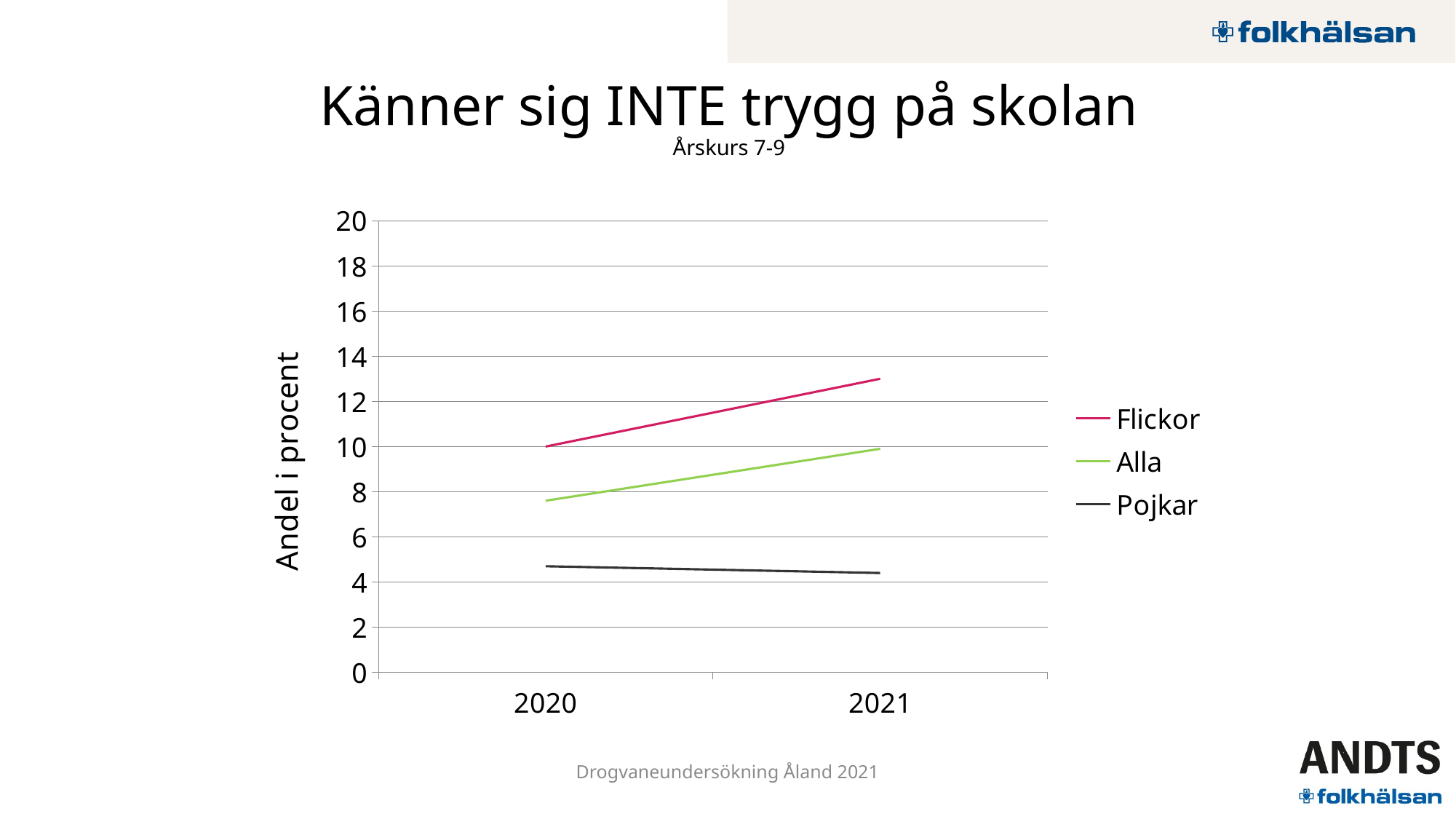
Does the Flickor line rise or fall from 2020 to 2021? rise What is the title of the y axis? Andel i procent What kind of chart is shown on the slide? line chart Does the Pojkar line rise or fall from 2020 to 2021? fall How many years are shown on the x axis? 2 Is the value for Flickor in 2021 greater or less than 12? greater How many series does the legend list? 3 Is the value for Pojkar in 2021 greater or less than 6? less Which series has the lowest value in 2020? Pojkar Is the value for Alla in 2020 greater or less than 8? less Which is larger in 2021, the value for Alla or the value for Pojkar? Alla Which series has the highest value in 2021? Flickor